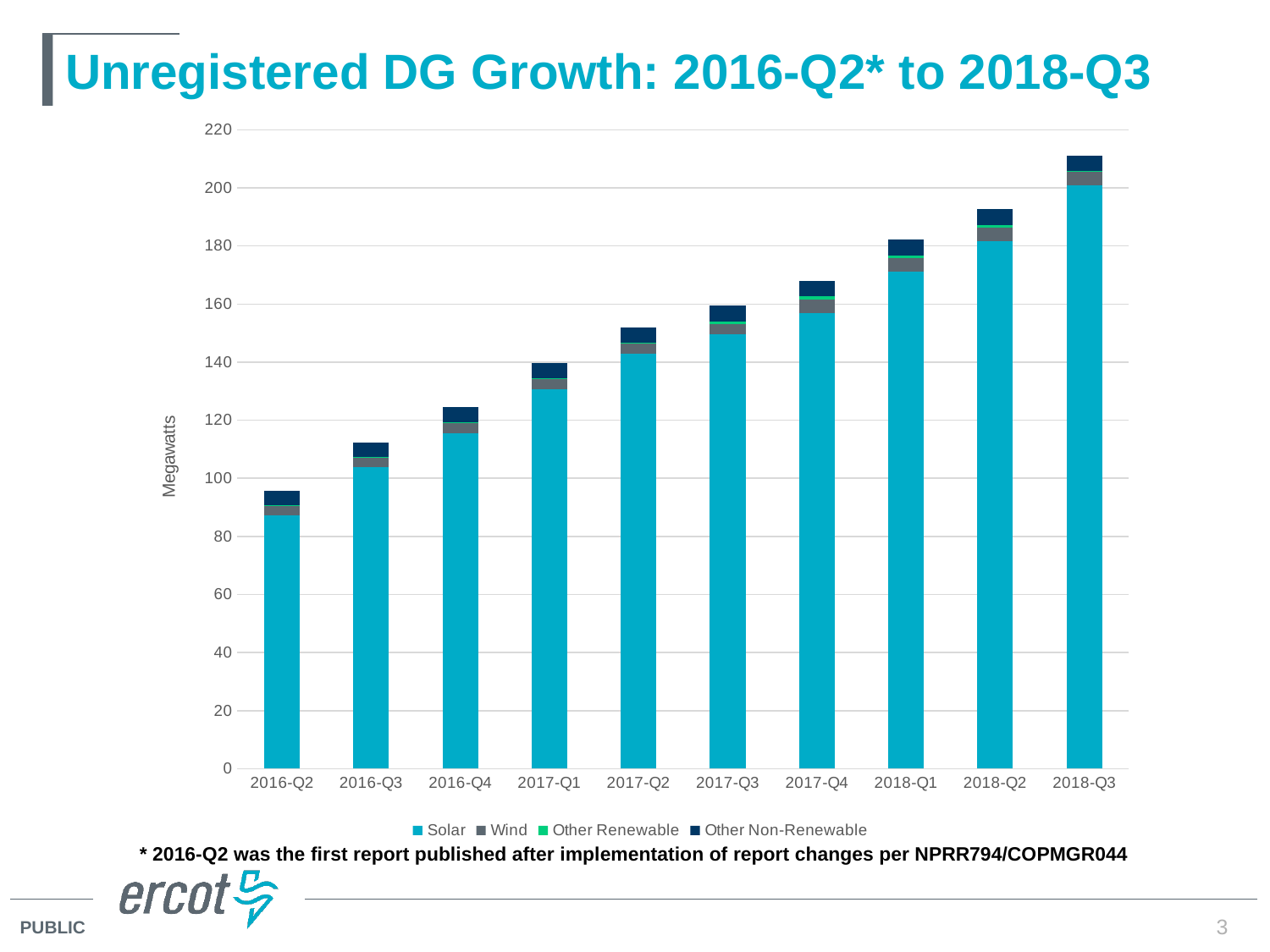
What is the label on the chart's vertical axis? Megawatts Is the total for 2017-Q4 greater or less than 180? less Is the total for 2018-Q3 greater or less than 200? greater Is the total for 2017-Q2 greater or less than 140? greater Which quarter has the highest total stacked bar? 2018-Q3 Do the total bar heights rise or fall from 2016-Q2 to 2018-Q3? Rise Which has the larger total bar, 2018-Q2 or 2017-Q1? 2018-Q2 Which quarter has the lowest total stacked bar? 2016-Q2 How many series does the chart's legend list? 4 How many quarters are shown along the x axis of the chart? 10 What kind of chart is shown on the slide? Stacked bar chart